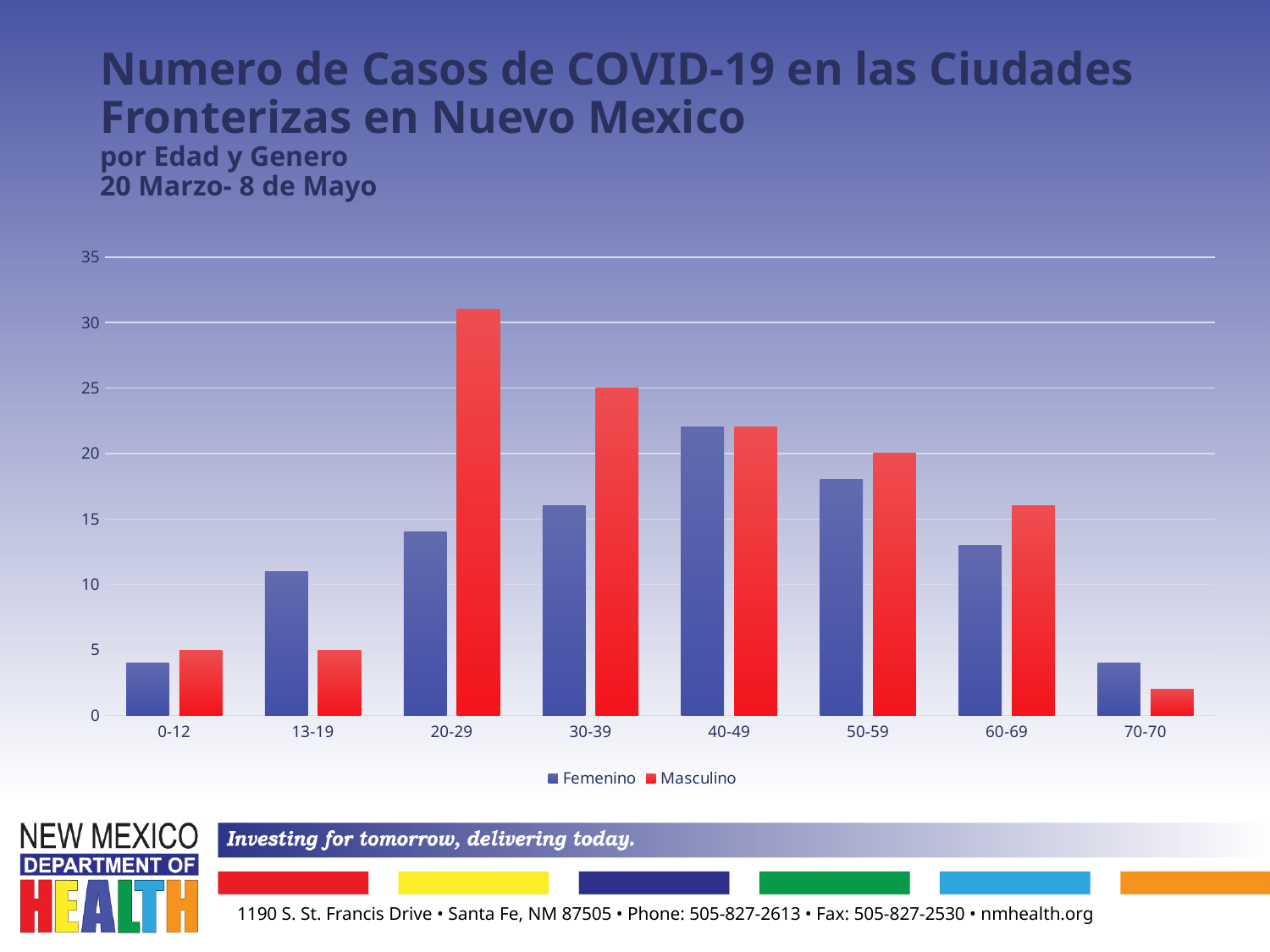
In the 13-19 age group, which is larger, Femenino or Masculino? Femenino Which age group has the highest Femenino value? 40-49 What is the Masculino value for the 30-39 age group? 25 Is the Femenino value for the 60-69 age group greater or less than 15? less How many series does the legend list? 2 How many age groups are shown on the x axis? 8 Is the Masculino value for the 20-29 age group greater or less than 30? greater Which age group has the lowest Masculino value? 70-70 What is the Masculino value for the 0-12 age group? 5 What is the Masculino value for the 50-59 age group? 20 Which age group has the highest Masculino value? 20-29 What kind of chart is shown on the slide? bar chart